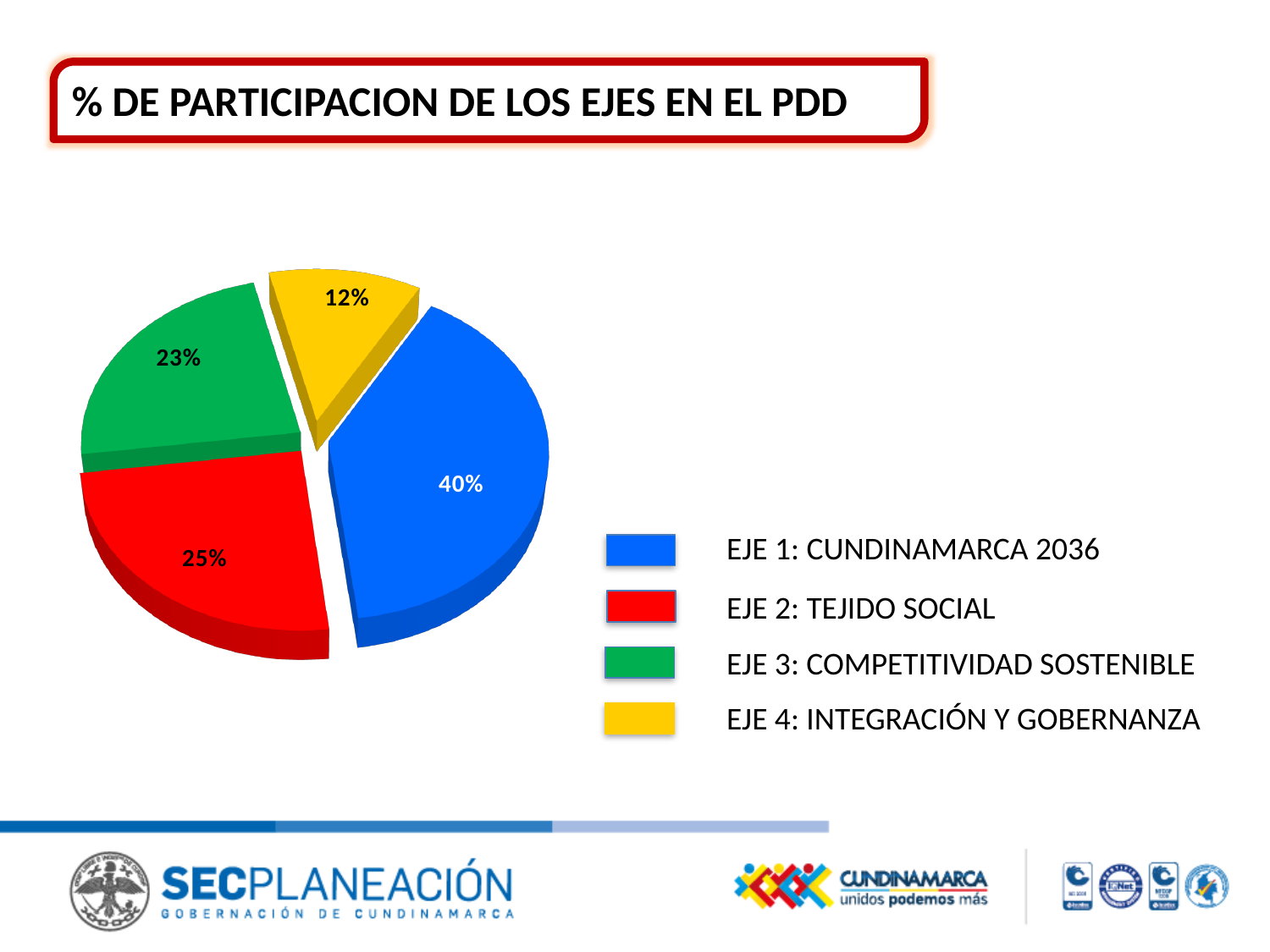
Which eje has the largest share of the pie? EJE 1: CUNDINAMARCA 2036 Which has a larger share, EJE 2: TEJIDO SOCIAL or EJE 3: COMPETITIVIDAD SOSTENIBLE? EJE 2: TEJIDO SOCIAL What kind of chart is shown on the slide? Pie chart What share of the pie does EJE 4: INTEGRACIÓN Y GOBERNANZA have? 12% How many slices does the pie chart have? 4 What is the difference in percentage points between EJE 1: CUNDINAMARCA 2036 and EJE 4: INTEGRACIÓN Y GOBERNANZA? 28 percentage points What share of the pie does EJE 3: COMPETITIVIDAD SOSTENIBLE have? 23% Which eje has the smallest share of the pie? EJE 4: INTEGRACIÓN Y GOBERNANZA What is the title of the chart? % DE PARTICIPACION DE LOS EJES EN EL PDD What share of the pie does EJE 2: TEJIDO SOCIAL have? 25% What colour represents EJE 3: COMPETITIVIDAD SOSTENIBLE in the legend? Green